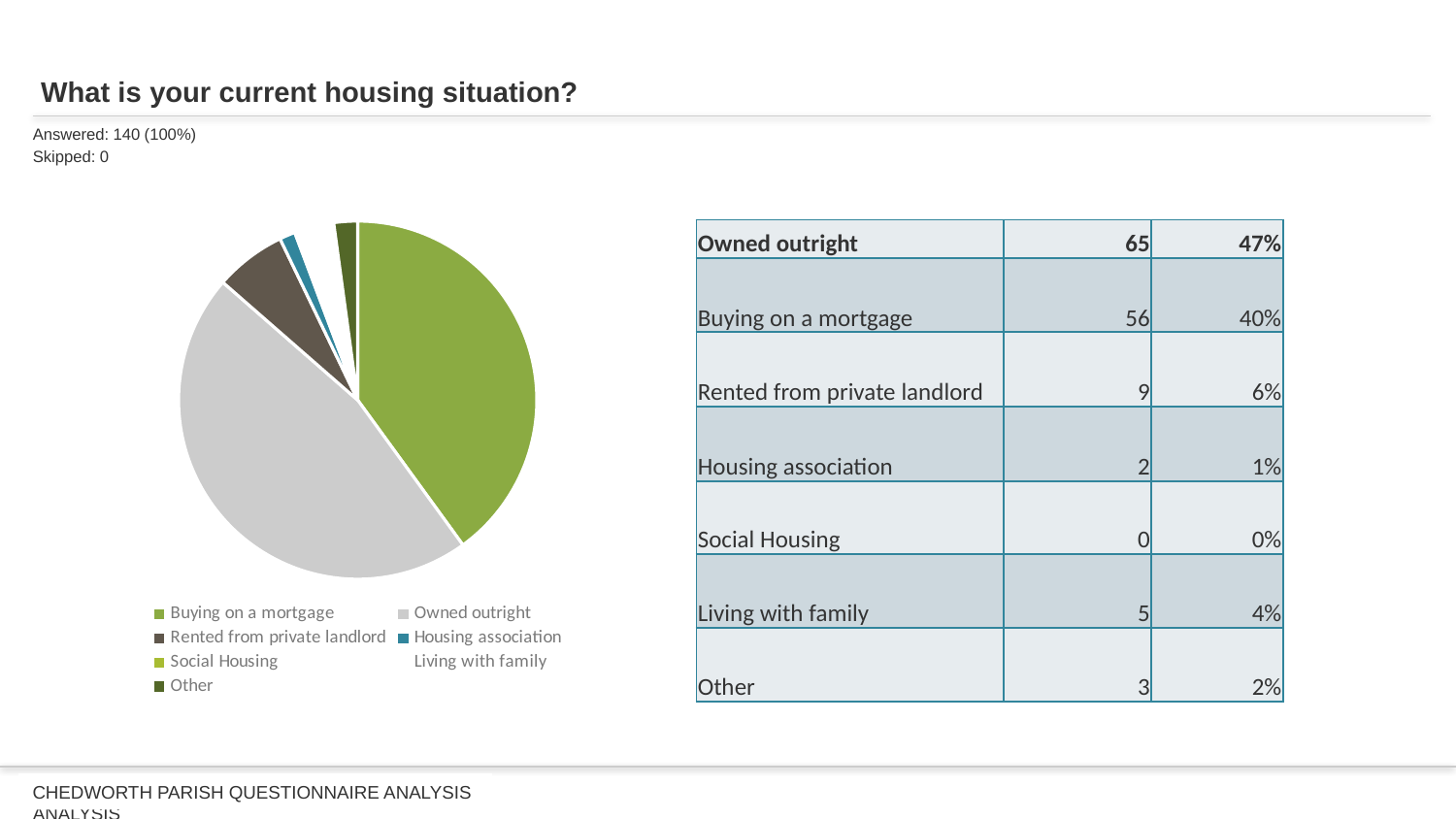
How many people answered the housing situation question in total? 140 Which housing category has the lowest number of respondents? Social Housing What is the difference in respondents between 'Owned outright' and 'Buying on a mortgage'? 9 What is the title of the question shown above the chart? What is your current housing situation? What percentage of respondents are 'Buying on a mortgage'? 40% Which has more respondents: 'Rented from private landlord' or 'Living with family'? Rented from private landlord Which housing category has the highest number of respondents? Owned outright What percentage of respondents selected 'Other'? 2% What kind of chart is shown on the slide? Pie chart How many respondents answered 'Owned outright'? 65 How many housing categories does the chart's legend list? 7 How many respondents selected 'Housing association'? 2